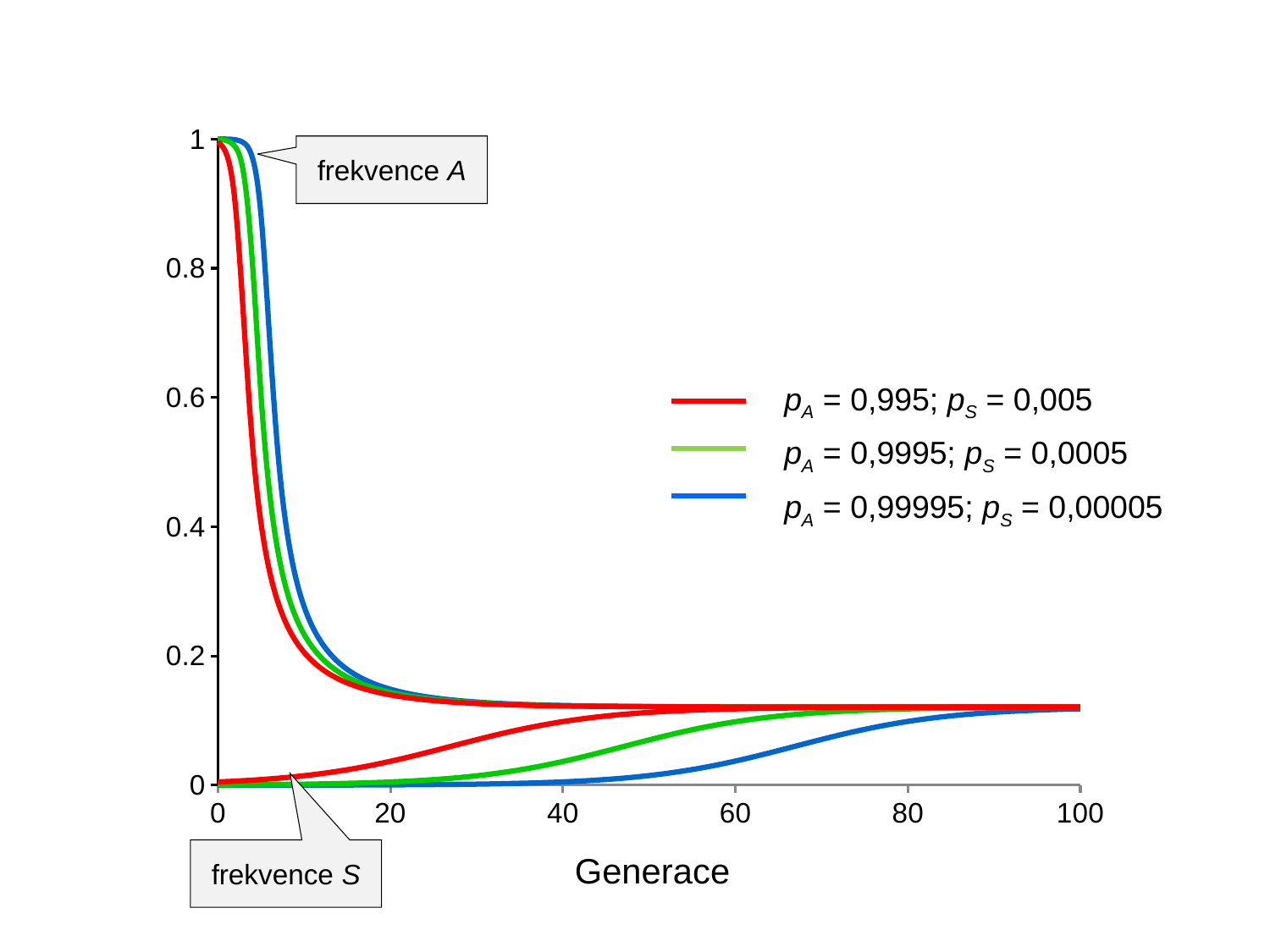
What is the label of the x axis? Generace What is the value of 'frekvence A' at generation 0? 1 What is the legend entry for the blue series? p_A = 0,99995; p_S = 0,00005 Do the 'frekvence S' curves rise or fall as the generation number increases? rise What kind of chart is shown on the slide? line chart Is the blue 'frekvence S' curve at generation 40 greater or less than 0.2? less How many series does the legend list? 3 At generation 60, which 'frekvence S' curve is higher, the red one or the blue one? red At generation 10, which 'frekvence A' curve is higher, the red one or the blue one? blue Is the red 'frekvence A' curve at generation 20 greater or less than 0.2? less Do the 'frekvence A' curves rise or fall as the generation number increases? fall What is the value of 'frekvence S' at generation 0? 0